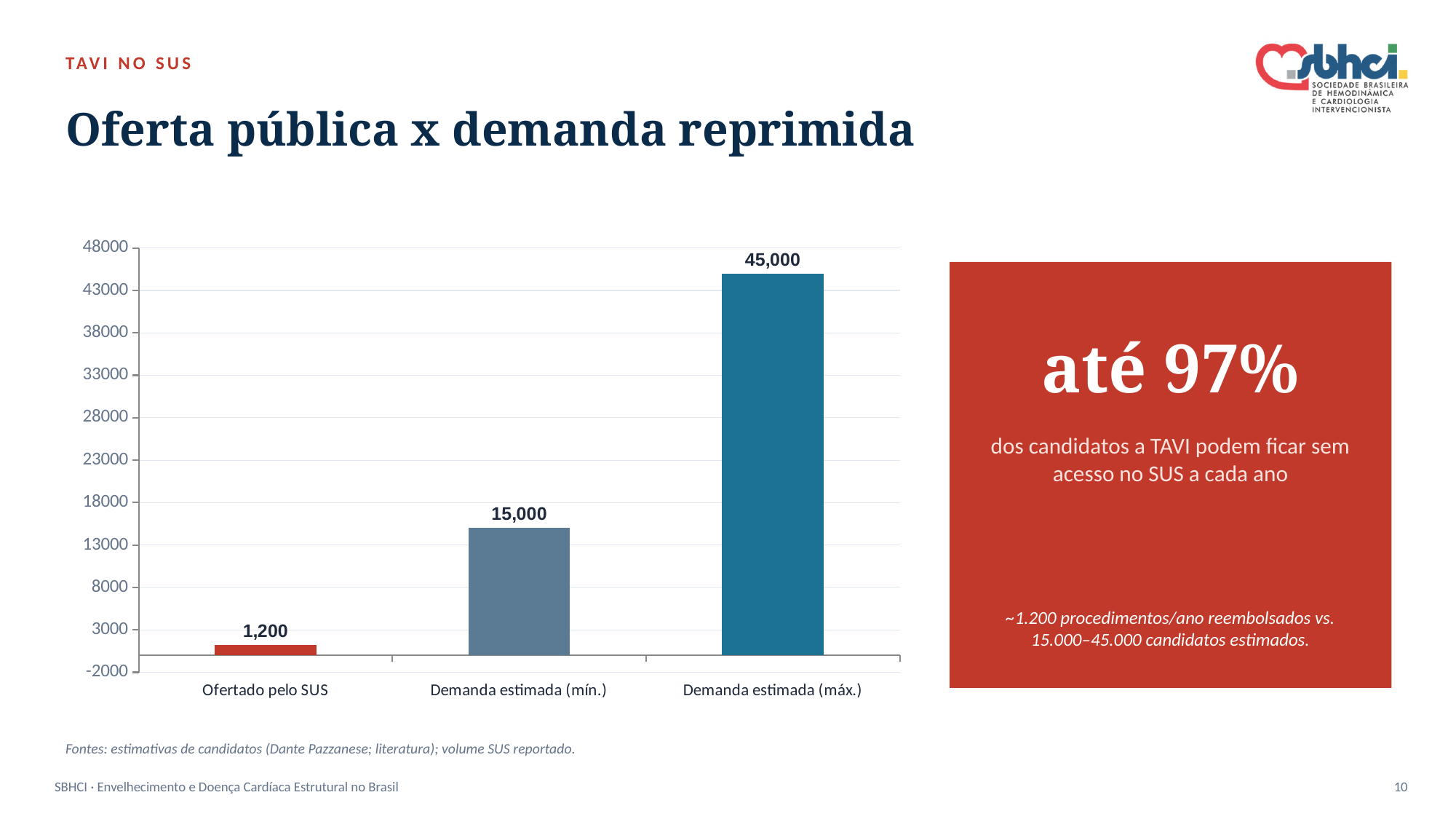
Is the value for Demanda estimada (máx.) greater or less than 43000? greater What is the difference between Demanda estimada (máx.) and Demanda estimada (mín.)? 30,000 What is the value for Ofertado pelo SUS? 1,200 Which category has the highest value? Demanda estimada (máx.) How many categories are shown in the chart? 3 What kind of chart is shown on the slide? Bar chart Do the values rise or fall from left to right across the categories? Rise Which category has the lowest value? Ofertado pelo SUS What is the difference between Demanda estimada (mín.) and Ofertado pelo SUS? 13,800 What is the value for Demanda estimada (mín.)? 15,000 What is the value for Demanda estimada (máx.)? 45,000 Which is larger, Ofertado pelo SUS or Demanda estimada (mín.)? Demanda estimada (mín.)